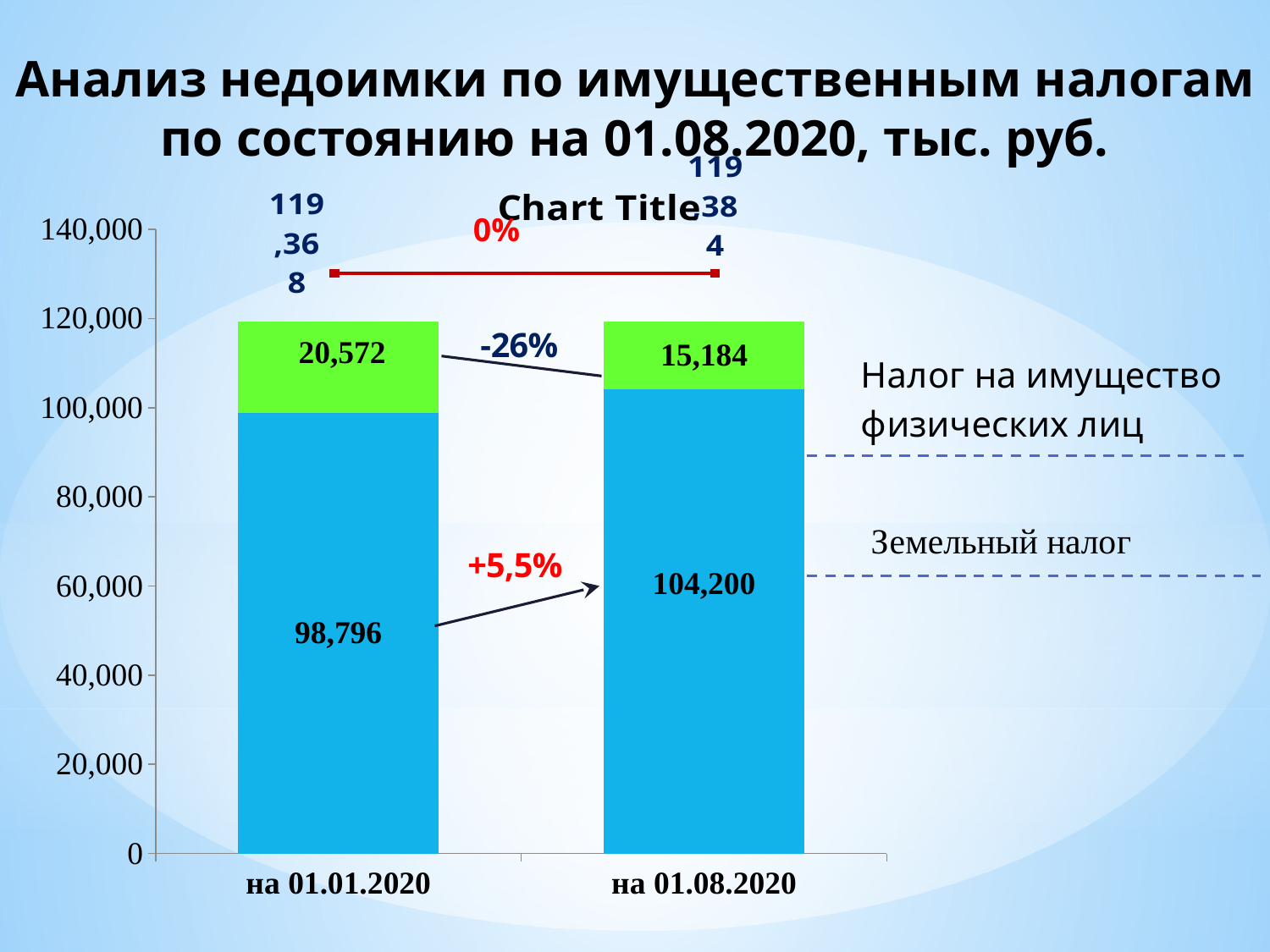
What percentage change is shown for Земельный налог between the two dates? +5,5% What is the value of Налог на имущество физических лиц for на 01.01.2020? 20,572 How many categories are shown on the x axis? 2 What is the total of the stacked bar for на 01.01.2020? 119,368 What percentage change is shown for Налог на имущество физических лиц between the two dates? -26% What is the value of Земельный налог for на 01.08.2020? 104,200 What is the difference between the Земельный налог values for на 01.08.2020 and на 01.01.2020? 5,404 What kind of chart is shown on the slide? Stacked bar chart What is the total of the stacked bar for на 01.08.2020? 119,384 What is the value of Налог на имущество физических лиц for на 01.08.2020? 15,184 Which category has the larger value for Налог на имущество физических лиц, на 01.01.2020 or на 01.08.2020? на 01.01.2020 What is the value of Земельный налог for на 01.01.2020? 98,796